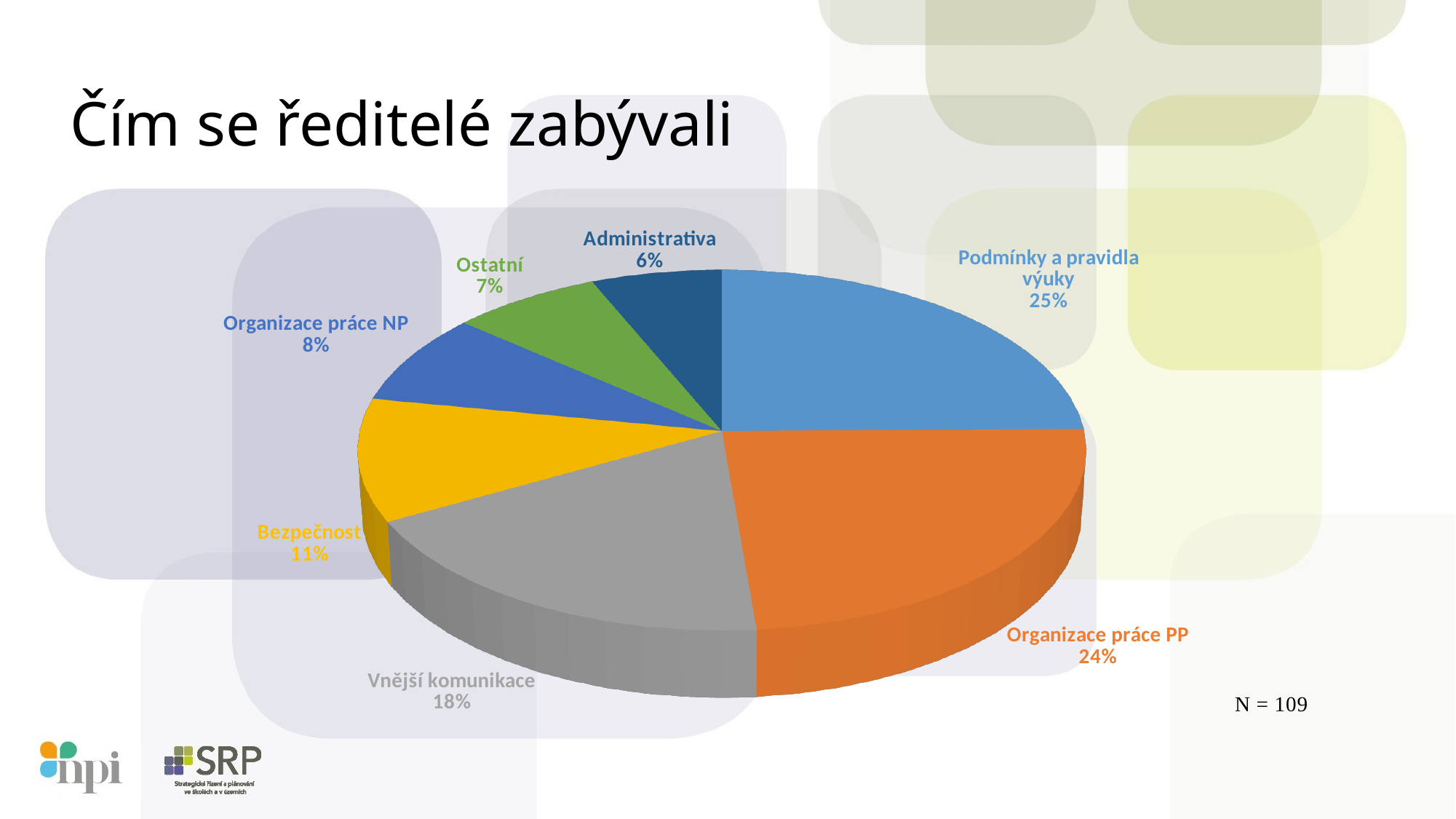
What value is shown for Vnější komunikace? 18% What share of the pie is labelled for Podmínky a pravidla výuky? 25% Which category has the smallest share of the pie? Administrativa What share of the pie is labelled for Organizace práce PP? 24% What is the title of the slide containing the pie chart? Čím se ředitelé zabývali How many slices does the pie chart have? 7 What value is shown for Administrativa? 6% What kind of chart is shown on the slide? pie chart Which is larger, Organizace práce NP or Ostatní? Organizace práce NP Which category has the largest share of the pie? Podmínky a pravidla výuky What is the difference in percentage points between Vnější komunikace and Bezpečnost? 7 What value is shown for Bezpečnost? 11%